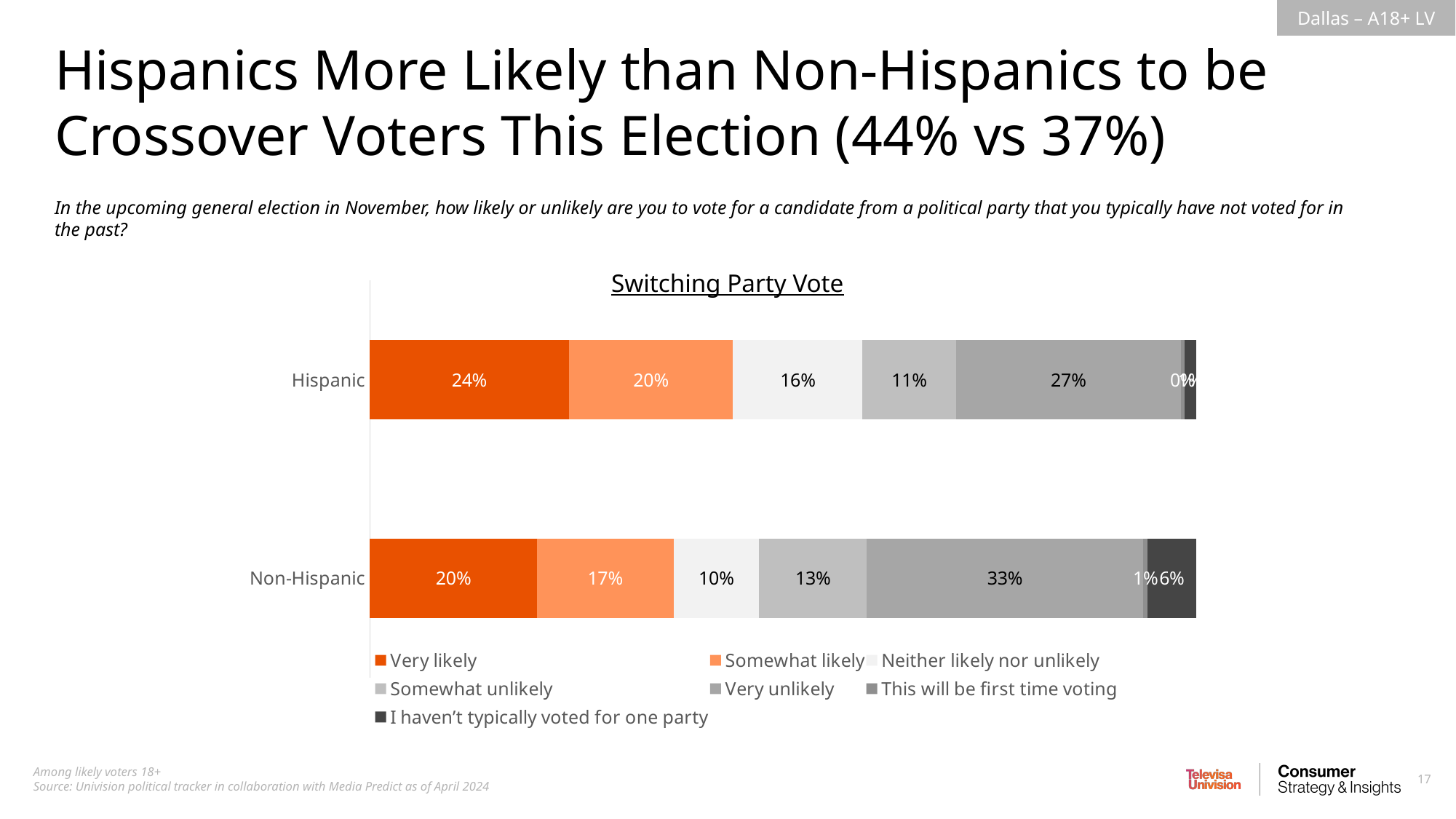
What percentage of Hispanic respondents are "Very likely" to switch party vote? 24% What is the title of the chart? Switching Party Vote What percentage of Non-Hispanic respondents are "Very unlikely" to switch party vote? 33% How many groups (bars) are shown in the chart? 2 How many response categories does the legend list? 7 Which response segment is the largest in the Non-Hispanic bar? Very unlikely What is the "I haven't typically voted for one party" value for Non-Hispanic respondents? 6% What is the "Somewhat likely" value for Hispanic respondents? 20% What is the "Neither likely nor unlikely" value for Non-Hispanic respondents? 10% What is the difference between the "Very unlikely" values for Non-Hispanic and Hispanic respondents? 6 percentage points What type of chart is shown on the slide? Stacked bar chart Which group has the higher "Very likely" value, Hispanic or Non-Hispanic? Hispanic